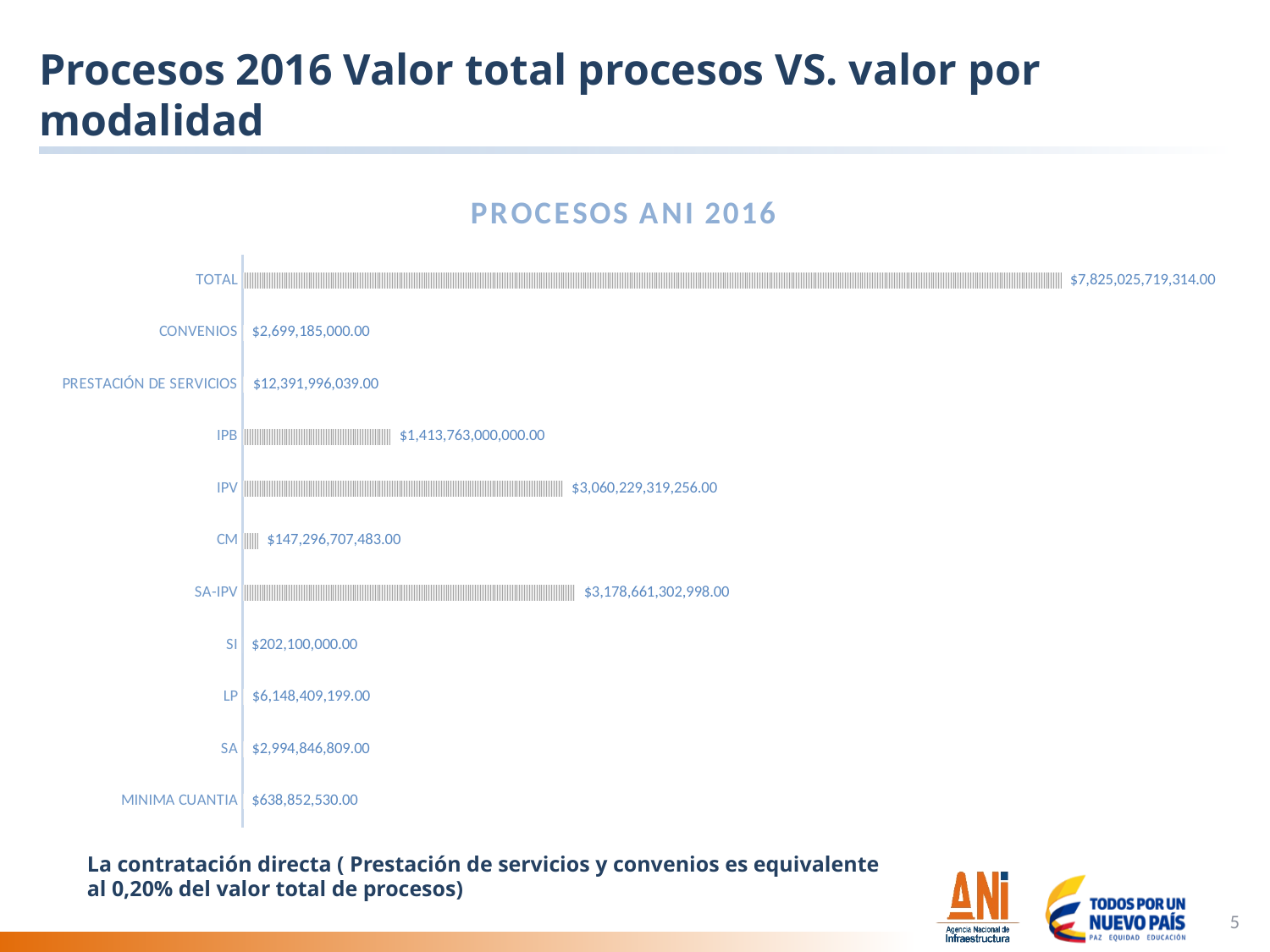
Which category has the highest value in the chart? TOTAL What type of chart is shown on the slide? Bar chart What is the value for IPV? $3,060,229,319,256.00 What is the value for TOTAL in the PROCESOS ANI 2016 chart? $7,825,025,719,314.00 What is the difference between the values for SA-IPV and IPV? $118,431,983,742.00 Which category has the lowest value in the chart? SI How many categories are shown in the chart? 11 What is the value for CM? $147,296,707,483.00 What is the value for MINIMA CUANTIA? $638,852,530.00 Excluding TOTAL, which category has the highest value? SA-IPV Which is larger, the value for IPB or the value for CM? IPB What is the value for PRESTACIÓN DE SERVICIOS? $12,391,996,039.00